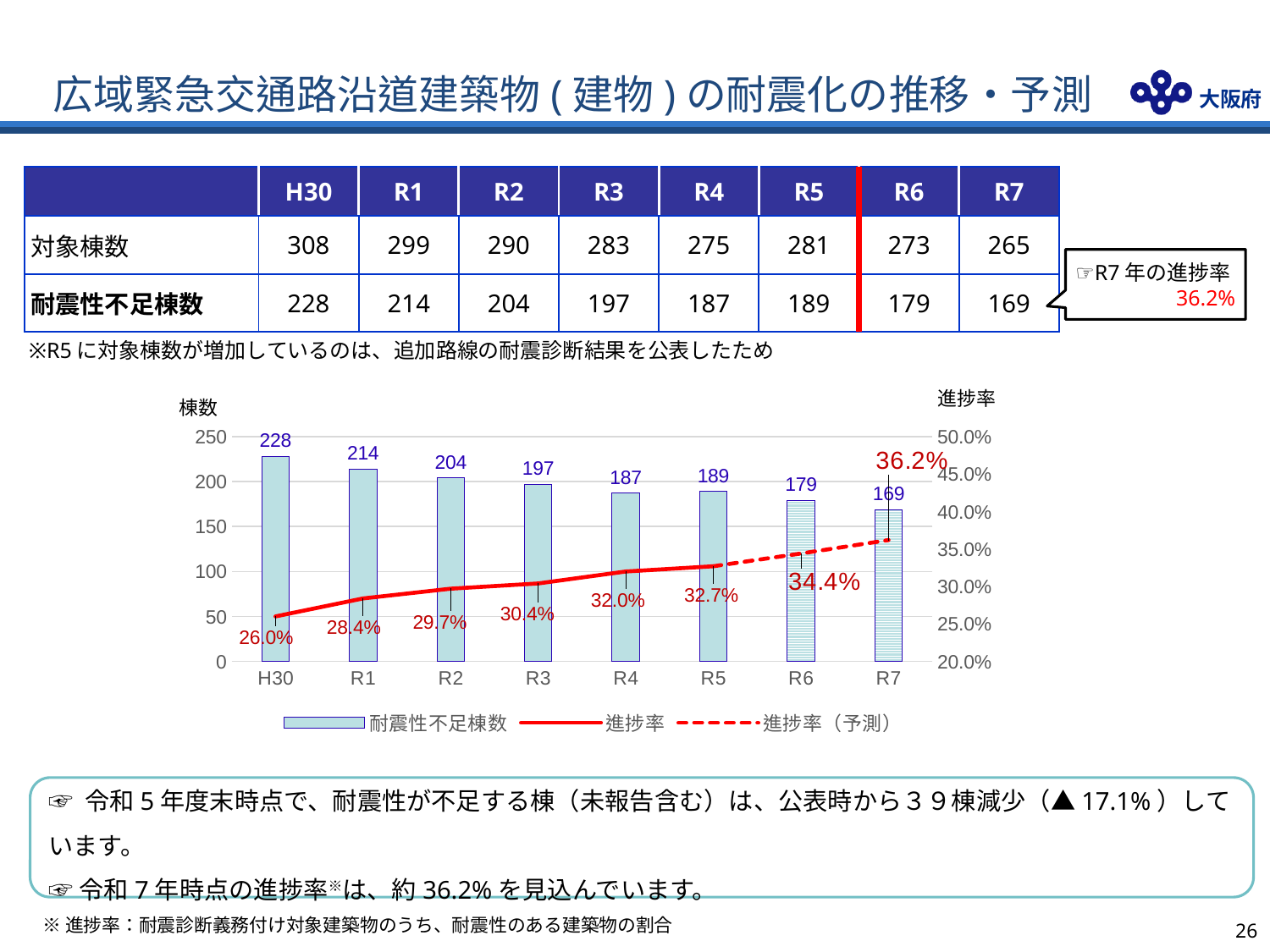
What is the 進捗率 shown for R4 in the chart? 32.0% Which category has the lowest 耐震性不足棟数 bar in the chart? R7 Which is larger in the chart, the 耐震性不足棟数 for R4 or for R5? R5 What is the difference in 耐震性不足棟数 between H30 and R7 in the chart? 59 Does the 進捗率 line rise or fall from H30 to R7 in the chart? Rise How many series does the chart legend list? 3 How many categories are shown on the x axis of the chart? 8 What kind of chart is shown on the slide? Combined bar and line chart Which category has the highest 耐震性不足棟数 bar in the chart? H30 What is the value of 耐震性不足棟数 for H30 in the chart? 228 What is the 進捗率 shown for R7 in the chart? 36.2% What is the value of 耐震性不足棟数 for R7 in the chart? 169